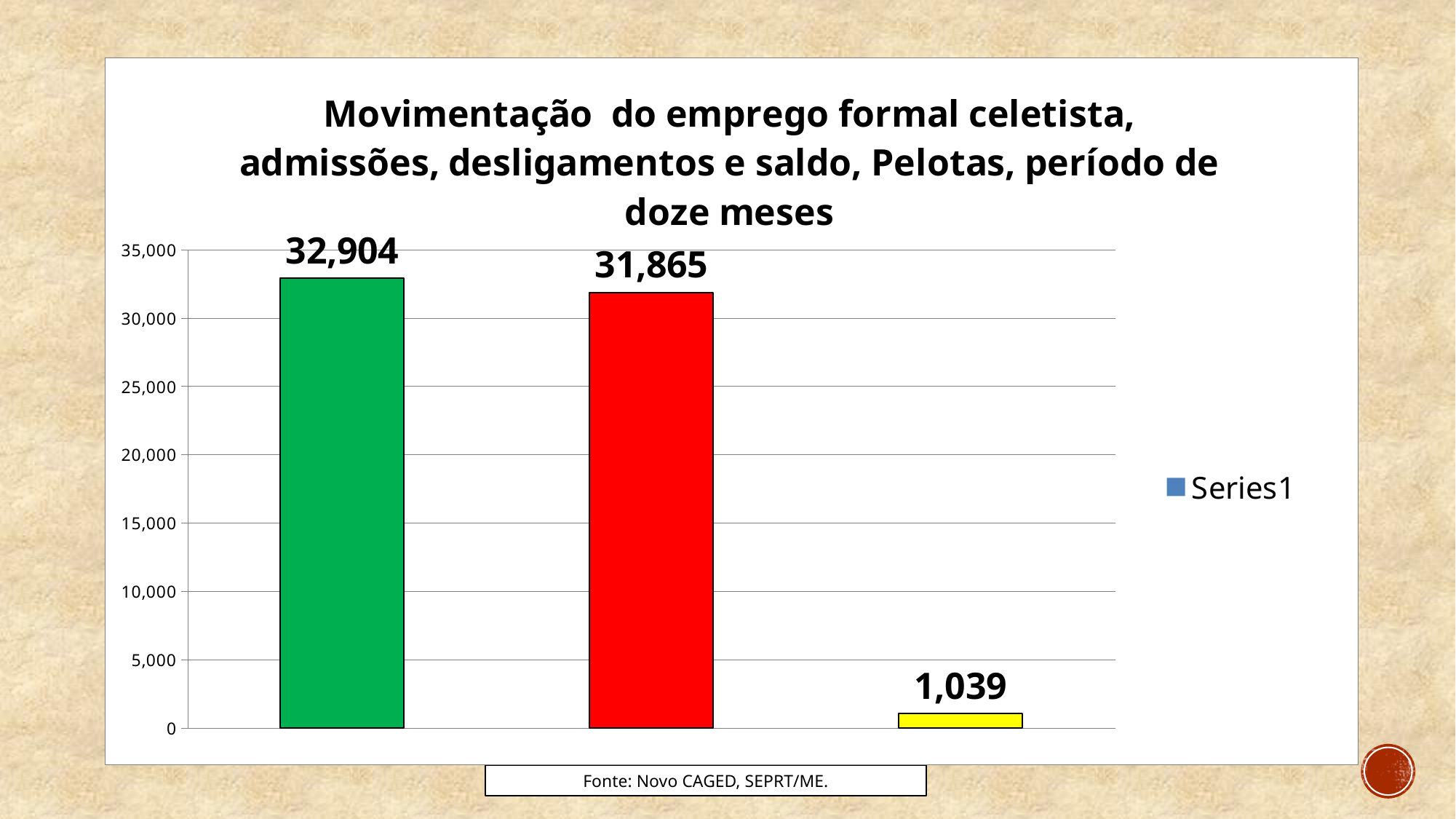
Is the value of the yellow bar greater or less than 5,000? less What value is shown on the red bar? 31,865 What is the difference between the green bar and the red bar? 1,039 What value is shown on the green bar? 32,904 What value is shown on the yellow bar? 1,039 How many series does the legend list? 1 Which bar has the lowest value? The yellow bar (1,039) Which is larger, the value of the red bar or the value of the yellow bar? The red bar Which bar has the highest value? The green bar (32,904) What kind of chart is shown on the slide? Bar chart What is the source cited below the chart? Fonte: Novo CAGED, SEPRT/ME. How many bars are plotted in the chart? 3